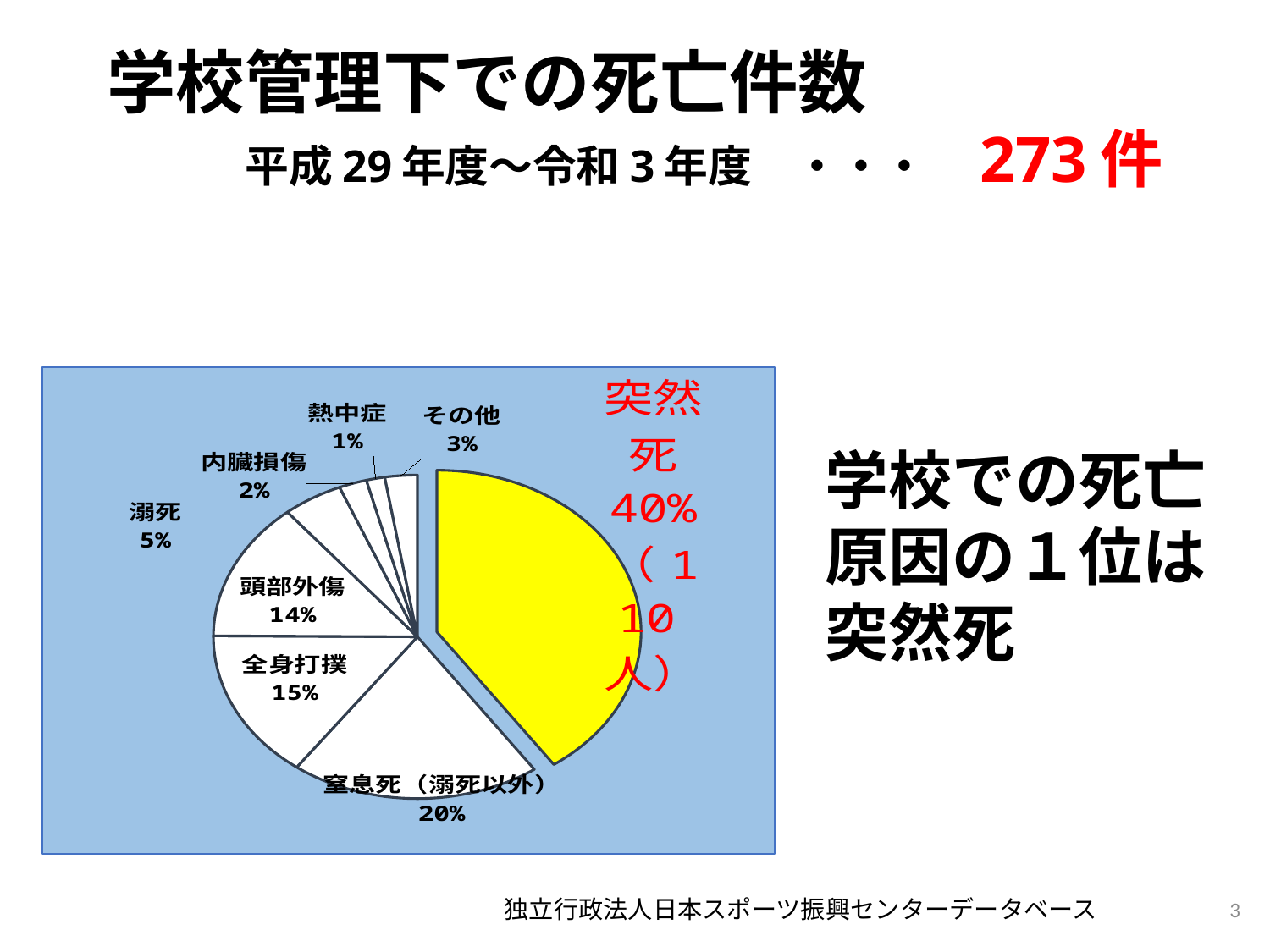
What is the value shown for 全身打撲? 15% Which category has the largest slice of the pie? 突然死 What share of the pie does 突然死 account for? 40% Which is larger, the share for 全身打撲 or the share for 頭部外傷? 全身打撲 What is the value shown for 窒息死（溺死以外）? 20% How many people does the 突然死 slice represent, according to its label? 110人 What is the value shown for 溺死? 5% What is the difference between the shares of 突然死 and 窒息死（溺死以外）? 20% What kind of chart is shown on the slide? pie chart What is the value shown for 頭部外傷? 14% Which category has the smallest slice of the pie? 熱中症 How many slices does the pie chart have? 8